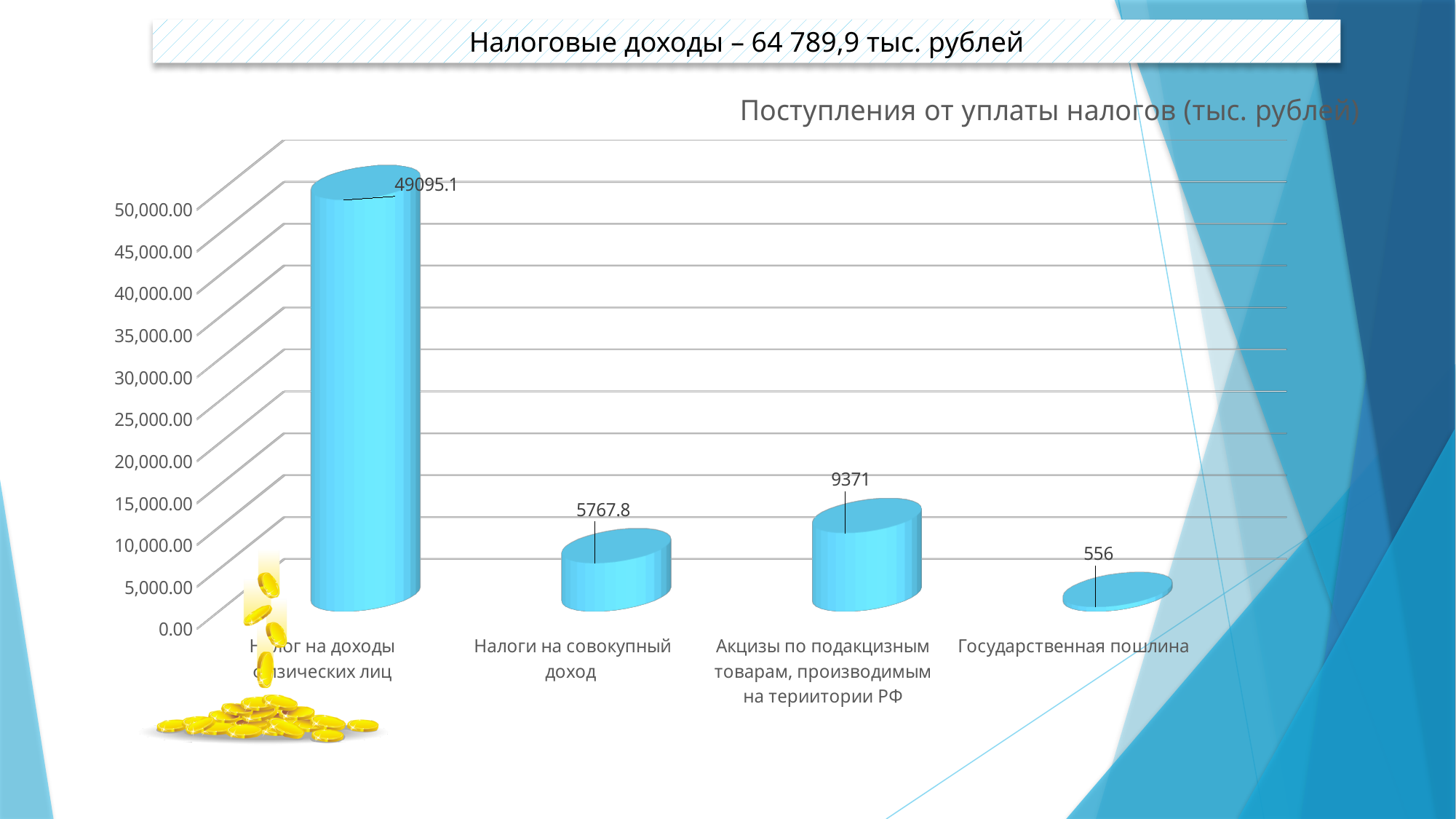
What is the value for Налоги на совокупный доход? 5767.8 Which is larger, the value for Налоги на совокупный доход or the value for Акцизы по подакцизным товарам, производимым на территории РФ? Акцизы по подакцизным товарам, производимым на территории РФ What is the difference between the values for Акцизы по подакцизным товарам, производимым на территории РФ and Налоги на совокупный доход? 3603.2 What is the title of the chart? Поступления от уплаты налогов (тыс. рублей) What is the difference between the values for Налог на доходы физических лиц and Государственная пошлина? 48539.1 How many categories are shown in the chart? 4 Which category has the highest value? Налог на доходы физических лиц What is the value for Акцизы по подакцизным товарам, производимым на территории РФ? 9371 What is the value for Налог на доходы физических лиц? 49095.1 Which category has the lowest value? Государственная пошлина What is the value for Государственная пошлина? 556 Is the value for Налоги на совокупный доход greater or less than 10,000.00? less